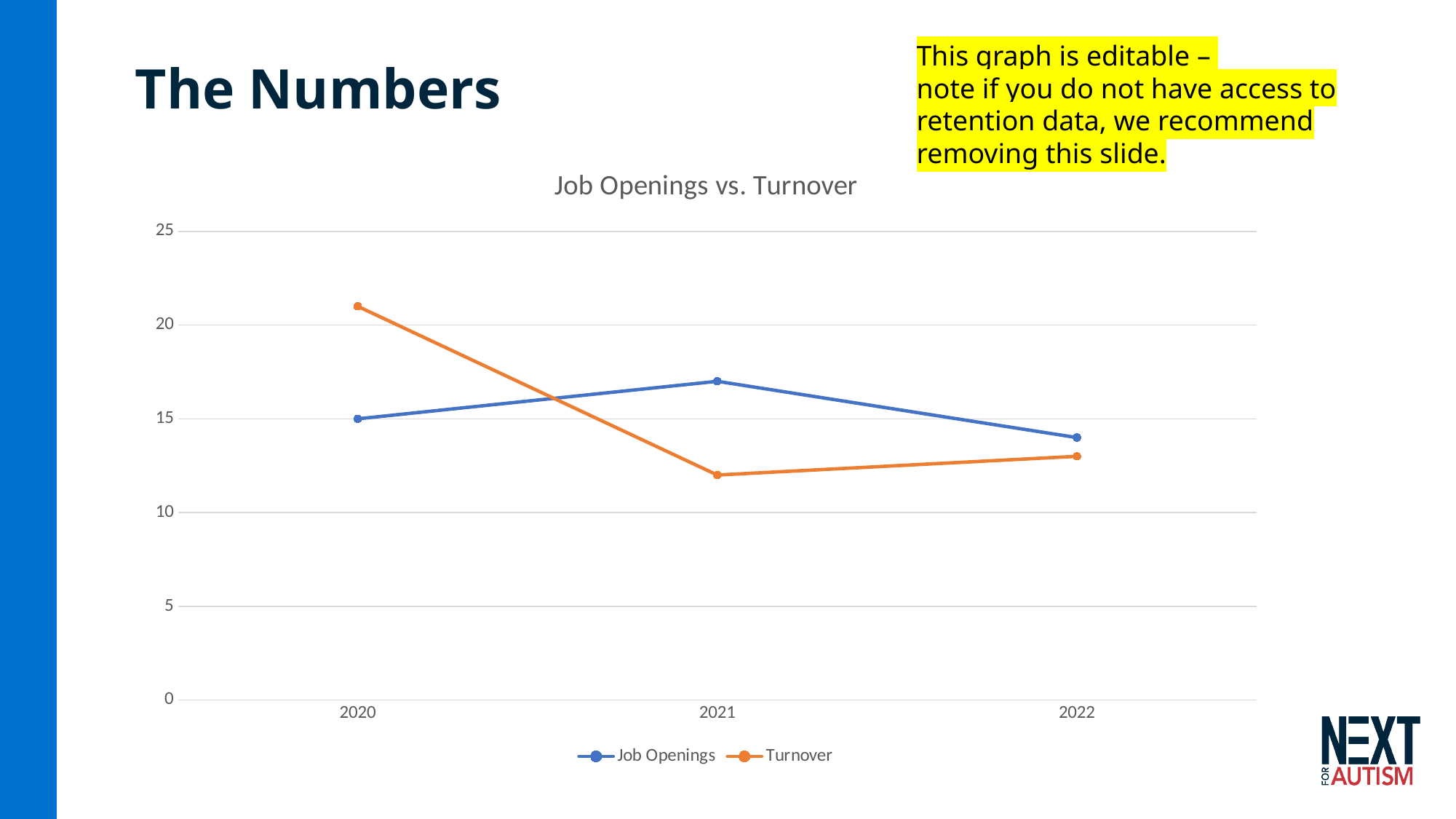
In 2020, which is larger, Job Openings or Turnover? Turnover Is the value for Turnover in 2020 greater or less than 20? greater Is the value for Job Openings in 2021 greater or less than 15? greater Is the value for Turnover in 2021 greater or less than 10? greater What kind of chart is shown on the slide? line chart How many years are plotted along the x axis? 3 How many series does the legend list? 2 What is the title of the chart? Job Openings vs. Turnover What is the value for Job Openings in 2020? 15 In which year is Turnover lowest? 2021 In which year is Turnover highest? 2020